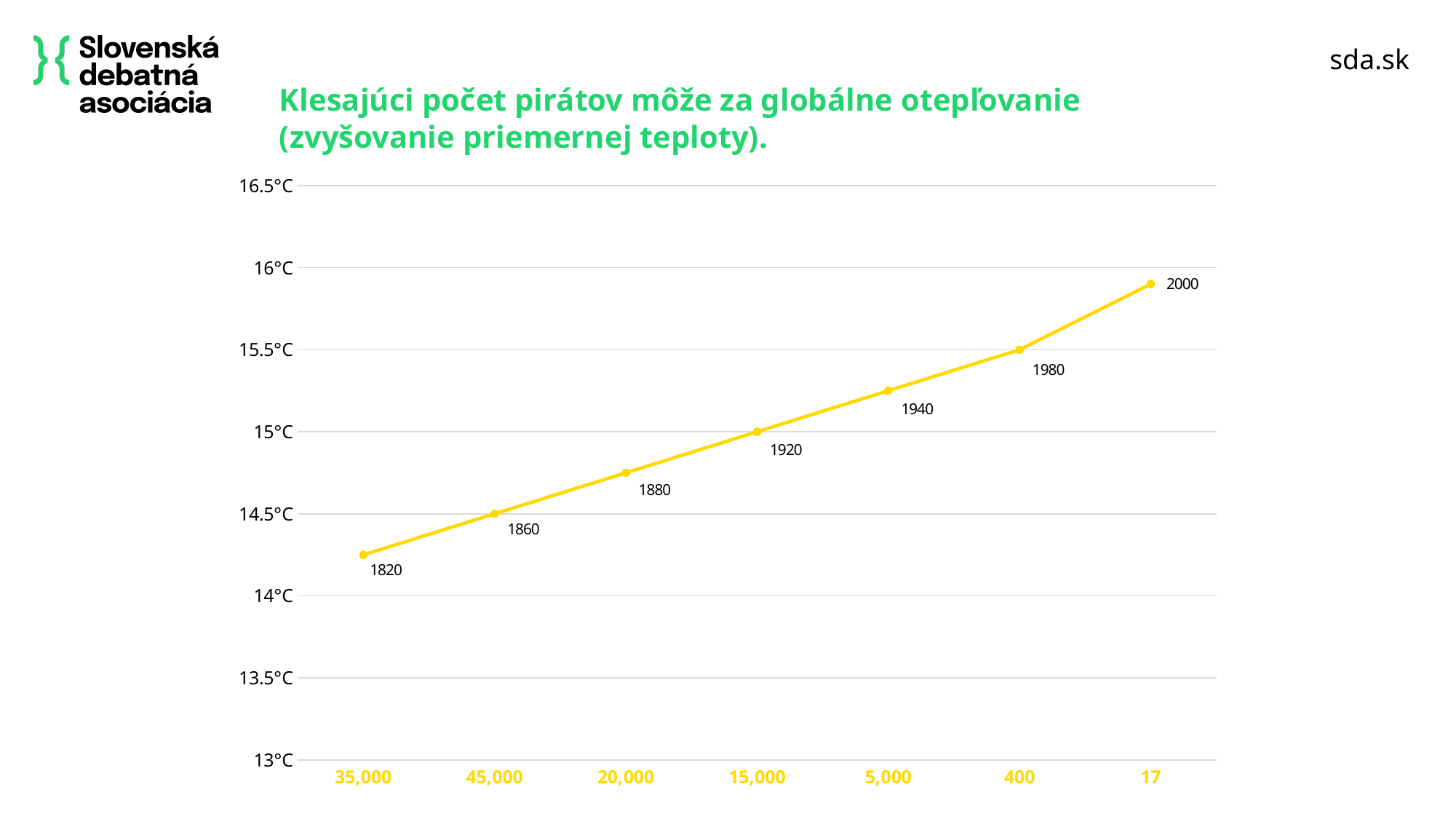
Do the plotted temperature values rise or fall from left to right along the x axis? rise How many data points are plotted on the line? 7 What temperature is plotted for the category 400 (labelled 1980)? 15.5°C Is the value for the category 35,000 greater or less than 14.5°C? less What temperature is plotted for the category 45,000 (labelled 1860)? 14.5°C What temperature is plotted for the category 15,000 (labelled 1920)? 15°C Is the value for the category 17 greater or less than 16°C? less Is the value for the category 20,000 greater or less than 15°C? less Which x-axis category has the lowest plotted temperature? 35,000 What is the difference between the temperature plotted for 400 (1980) and for 45,000 (1860)? 1°C Which x-axis category has the highest plotted temperature? 17 What kind of chart is shown on the slide? line chart